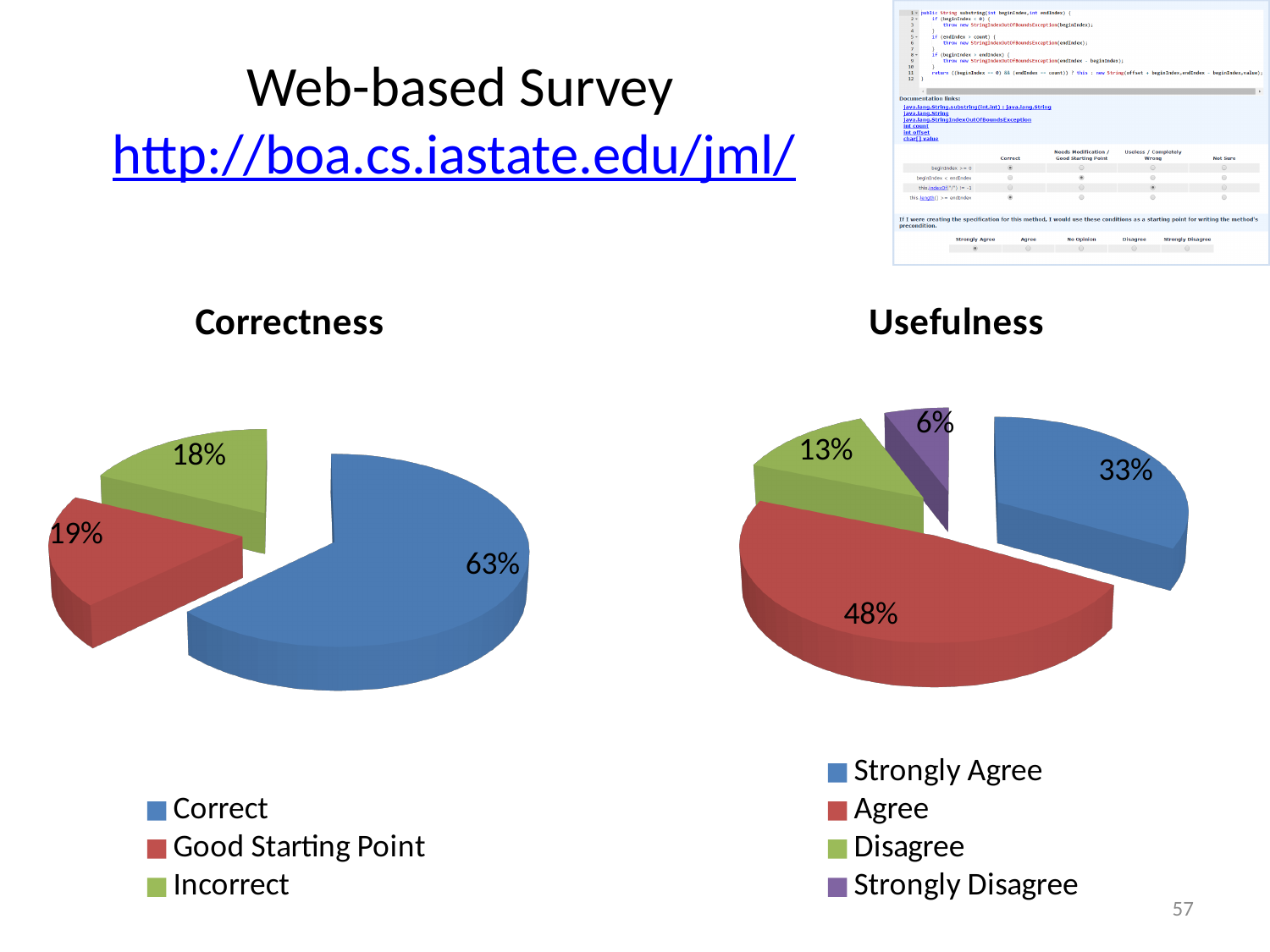
In the Usefulness chart, which is larger: Strongly Agree or Agree? Agree In the Correctness chart, which category has the largest share? Correct In the Usefulness chart, how many categories does the legend list? 4 In the Usefulness chart, what share of responses were Strongly Disagree? 6% In the Usefulness chart, what share of responses were Agree? 48% In the Correctness chart, how many categories does the legend list? 3 In the Correctness chart, what share of responses were Good Starting Point? 19% In the Correctness chart, what share of responses were Correct? 63% What type of chart is the Usefulness chart? Pie chart In the Correctness chart, what share of responses were Incorrect? 18% In the Usefulness chart, which category has the smallest share? Strongly Disagree In the Usefulness chart, what is the difference between the Agree and Disagree shares? 35%